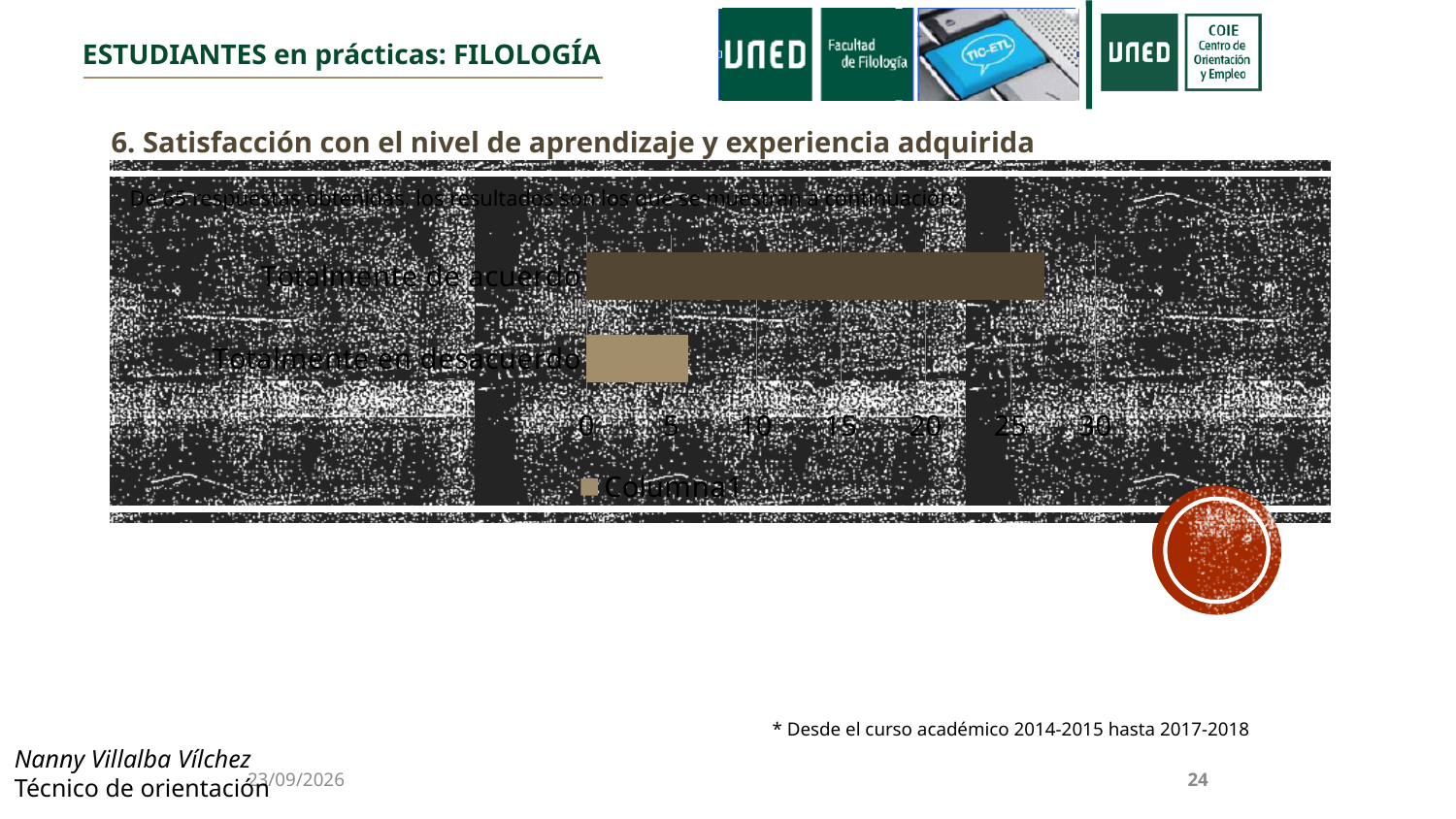
What kind of chart is shown on the slide? bar chart What is the name of the series shown in the legend of the bar chart? Columna1 How many categories does the bar chart show? 2 What is the highest value shown on the horizontal axis of the bar chart? 30 Is the value for Totalmente de acuerdo greater or less than 30? less Which category has the highest value in the bar chart? Totalmente de acuerdo How many series does the legend of the bar chart list? 1 Is the value for Totalmente de acuerdo greater or less than 20? greater Is the value for Totalmente en desacuerdo greater or less than 10? less Which is larger in the bar chart, the value for Totalmente de acuerdo or the value for Totalmente en desacuerdo? Totalmente de acuerdo Which category has the lowest value in the bar chart? Totalmente en desacuerdo